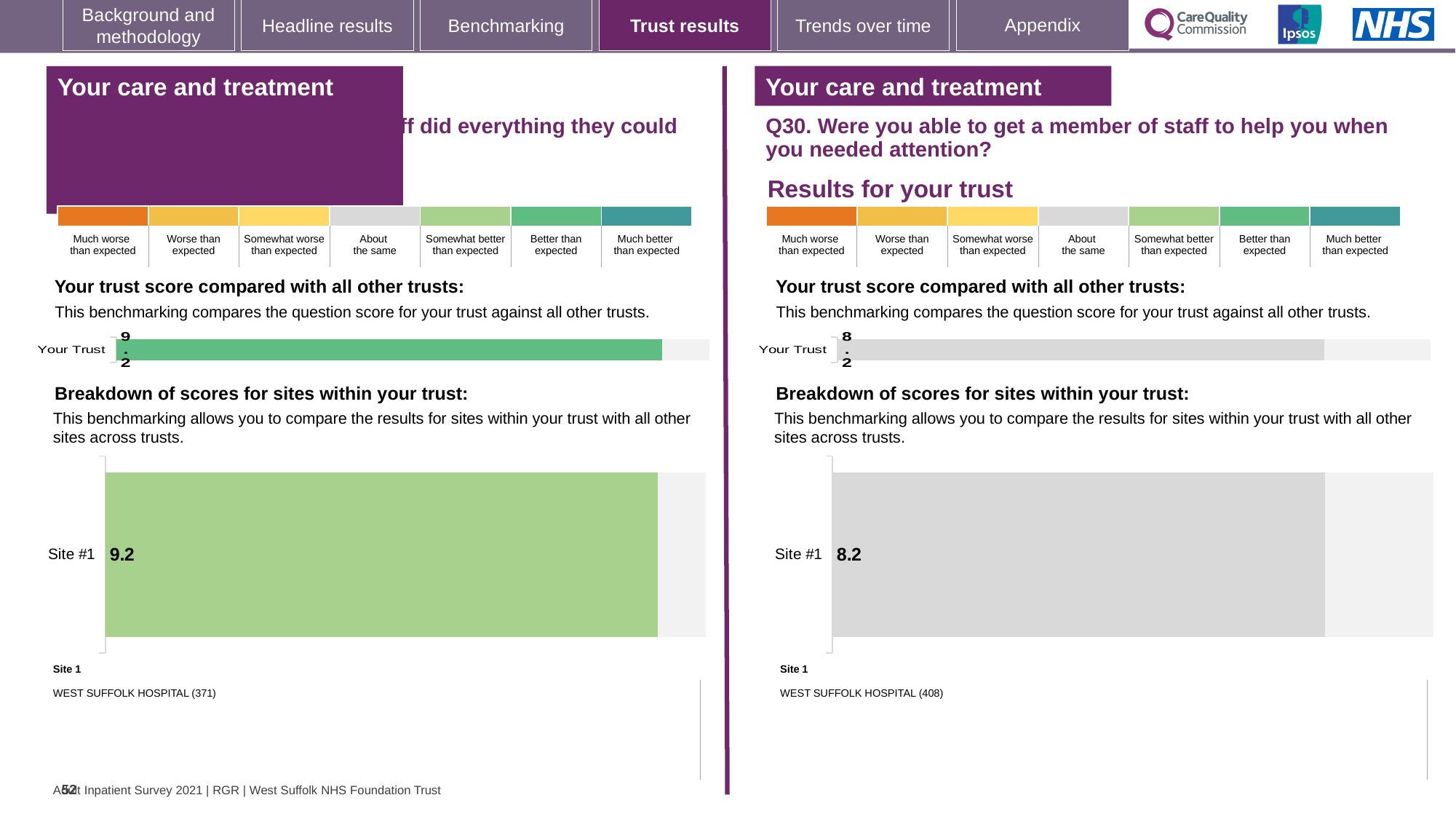
On the left half of the slide, what is the score shown for Your Trust in the 'Your trust score compared with all other trusts' bar chart? 9.2 In the left 'Breakdown of scores for sites within your trust' chart, what is the score for Site #1? 9.2 Is the Site #1 score in the right (Q30) breakdown chart greater or less than 9? less Which site is listed as Site 1 under the left breakdown chart? WEST SUFFOLK HOSPITAL (371) In the right (Q30) 'Breakdown of scores for sites within your trust' chart, what is the score for Site #1? 8.2 Which site is listed as Site 1 under the right (Q30) breakdown chart? WEST SUFFOLK HOSPITAL (408) How many sites are shown in the left 'Breakdown of scores for sites within your trust' chart? 1 On the right half of the slide (Q30), what is the score shown for Your Trust in the 'Your trust score compared with all other trusts' bar chart? 8.2 Which is larger: the Your Trust score on the left half of the slide or the Your Trust score for Q30 on the right half? The left half (9.2) What is the difference between the Site #1 score on the left chart and the Site #1 score on the right (Q30) chart? 1.0 How many sites are shown in the right (Q30) 'Breakdown of scores for sites within your trust' chart? 1 What type of chart is used to show the Your Trust score on each half of the slide? Bar chart